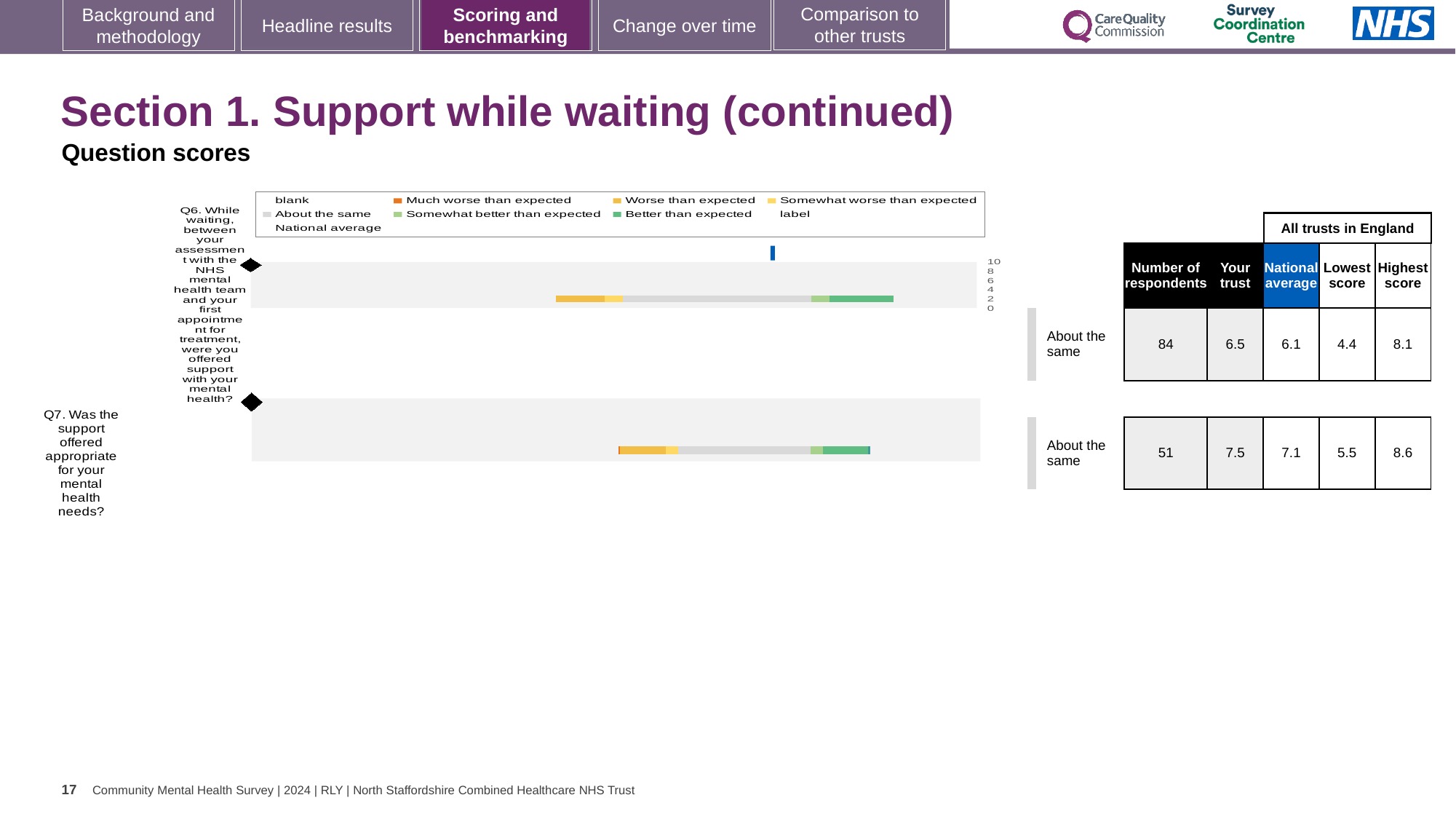
How many respondents answered Q6? 84 What is the highest score among all trusts in England for Q7? 8.6 What colour represents 'Better than expected' in the legend? green How many questions (categories) are plotted in the chart? 2 What benchmark category is shown for Q6? About the same For Q7, which is larger: the 'Your trust' score or the national average? Your trust What kind of chart is shown on the slide? bar chart What is the 'Your trust' score for Q6? 6.5 What is the difference between the 'Your trust' score and the national average for Q7? 0.4 What is the difference between the highest and lowest scores for Q6? 3.7 Which question had more respondents, Q6 or Q7? Q6 What is the national average score for Q7? 7.1